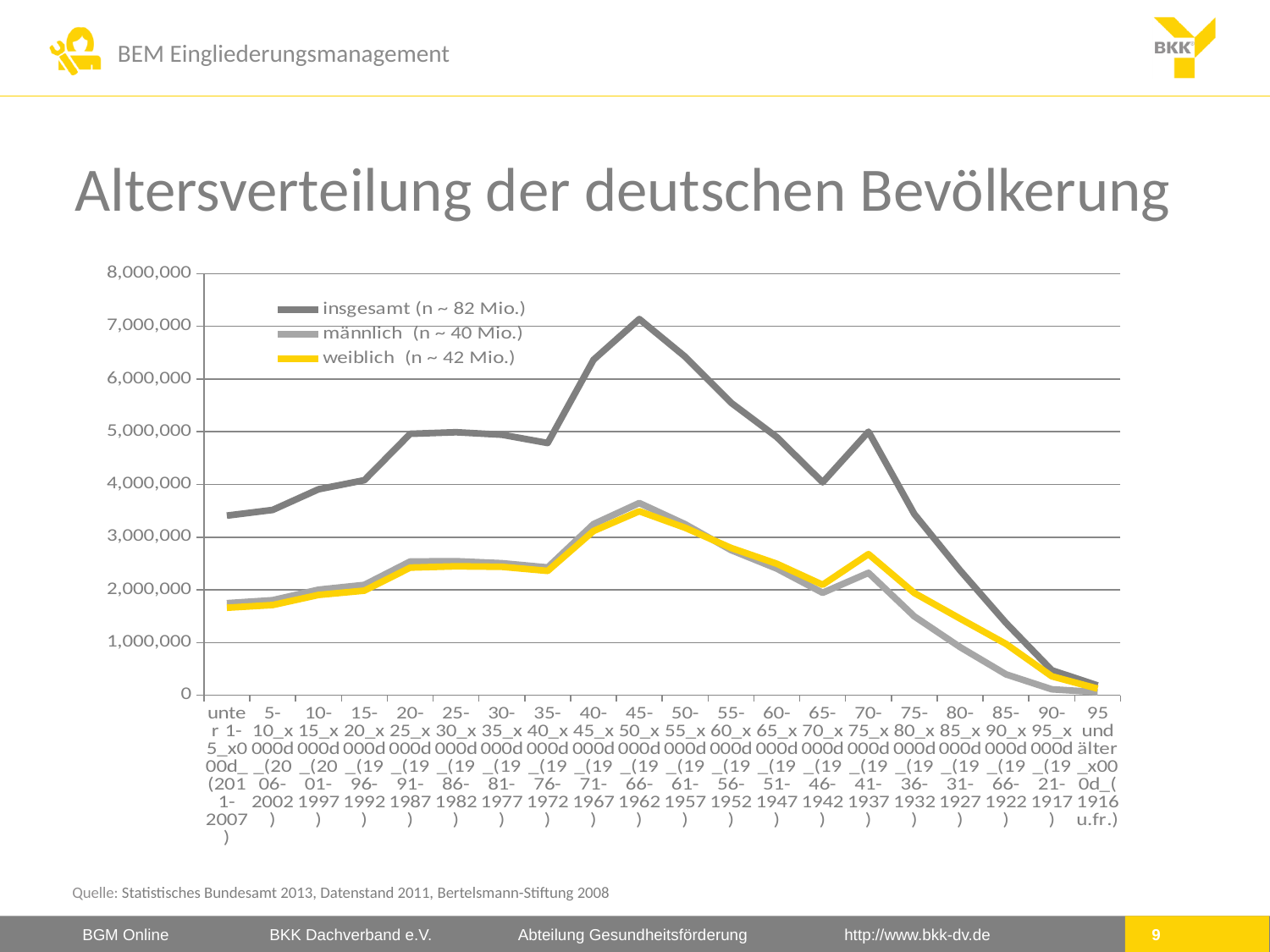
How many series does the legend list? 3 Is the value of 'weiblich' for the 70-75 age group greater or less than 2,000,000? greater In which age group does the 'insgesamt' series reach its highest value? 45-50 In which age group does the 'insgesamt' series have its lowest value? 95 und älter Is the value of 'insgesamt' for the 95 und älter age group greater or less than 1,000,000? less For the 85-90 age group, which is larger: 'männlich' or 'weiblich'? weiblich How many age-group categories are plotted along the x axis? 20 What is the title of the chart? Altersverteilung der deutschen Bevölkerung Does the 'insgesamt' series rise or fall between the 45-50 and 65-70 age groups? fall What kind of chart is shown on the slide? line chart Which series is drawn in yellow? weiblich (n ~ 42 Mio.) Is the value of 'insgesamt' for the 45-50 age group greater or less than 6,000,000? greater